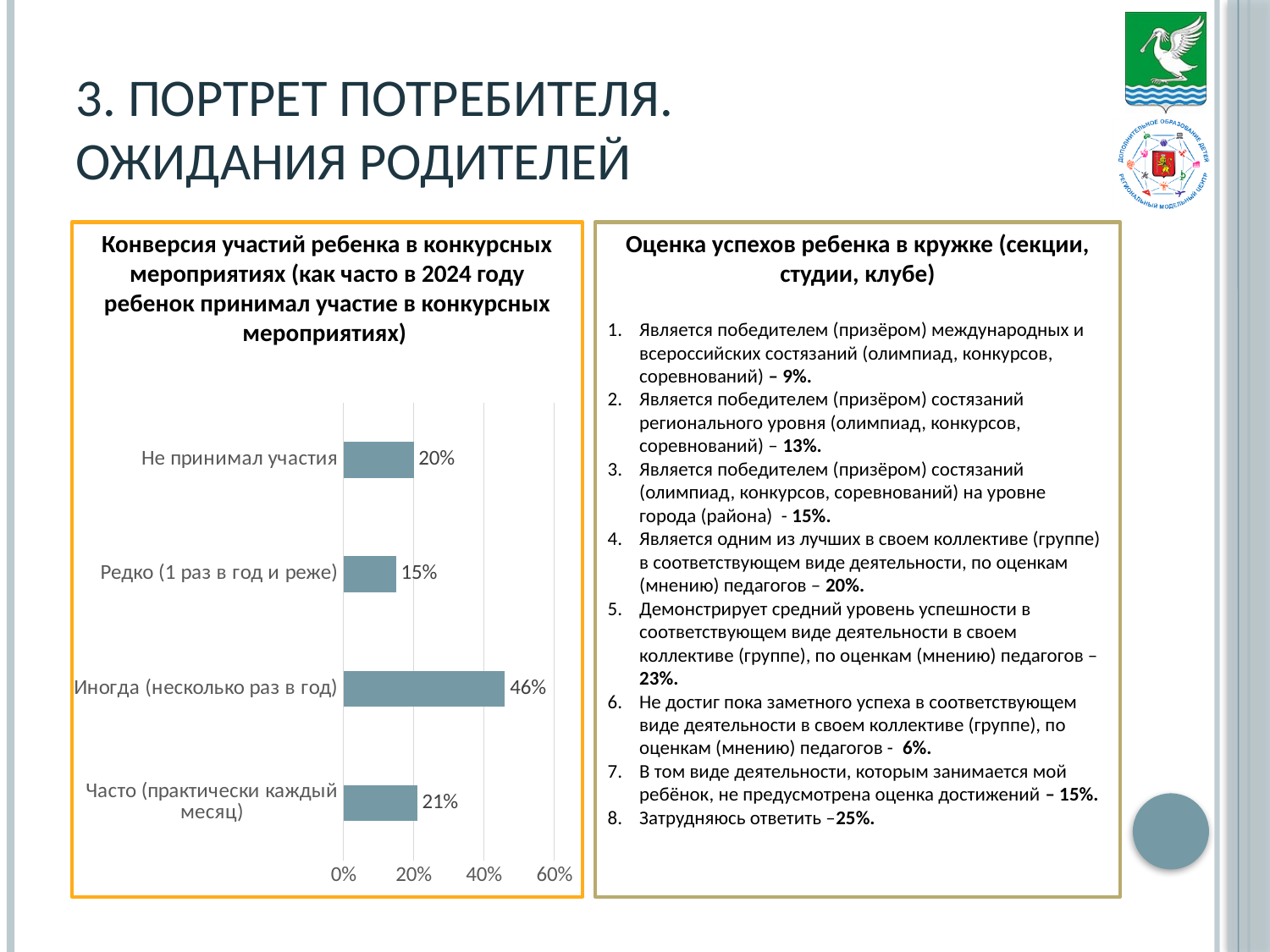
What type of chart is shown on the slide? Bar chart Which category has the highest value? Иногда (несколько раз в год) Which is larger: the value for "Часто (практически каждый месяц)" or the value for "Редко (1 раз в год и реже)"? Часто (практически каждый месяц) What is the value for "Иногда (несколько раз в год)"? 46% Is the value for "Иногда (несколько раз в год)" greater or less than 40%? greater Which category has the lowest value? Редко (1 раз в год и реже) What is the maximum value shown on the chart's horizontal axis? 60% What is the value for "Часто (практически каждый месяц)"? 21% How many categories are shown in the chart? 4 What is the value for "Не принимал участия"? 20% What is the difference between the values for "Иногда (несколько раз в год)" and "Часто (практически каждый месяц)"? 25% What is the value for "Редко (1 раз в год и реже)"? 15%